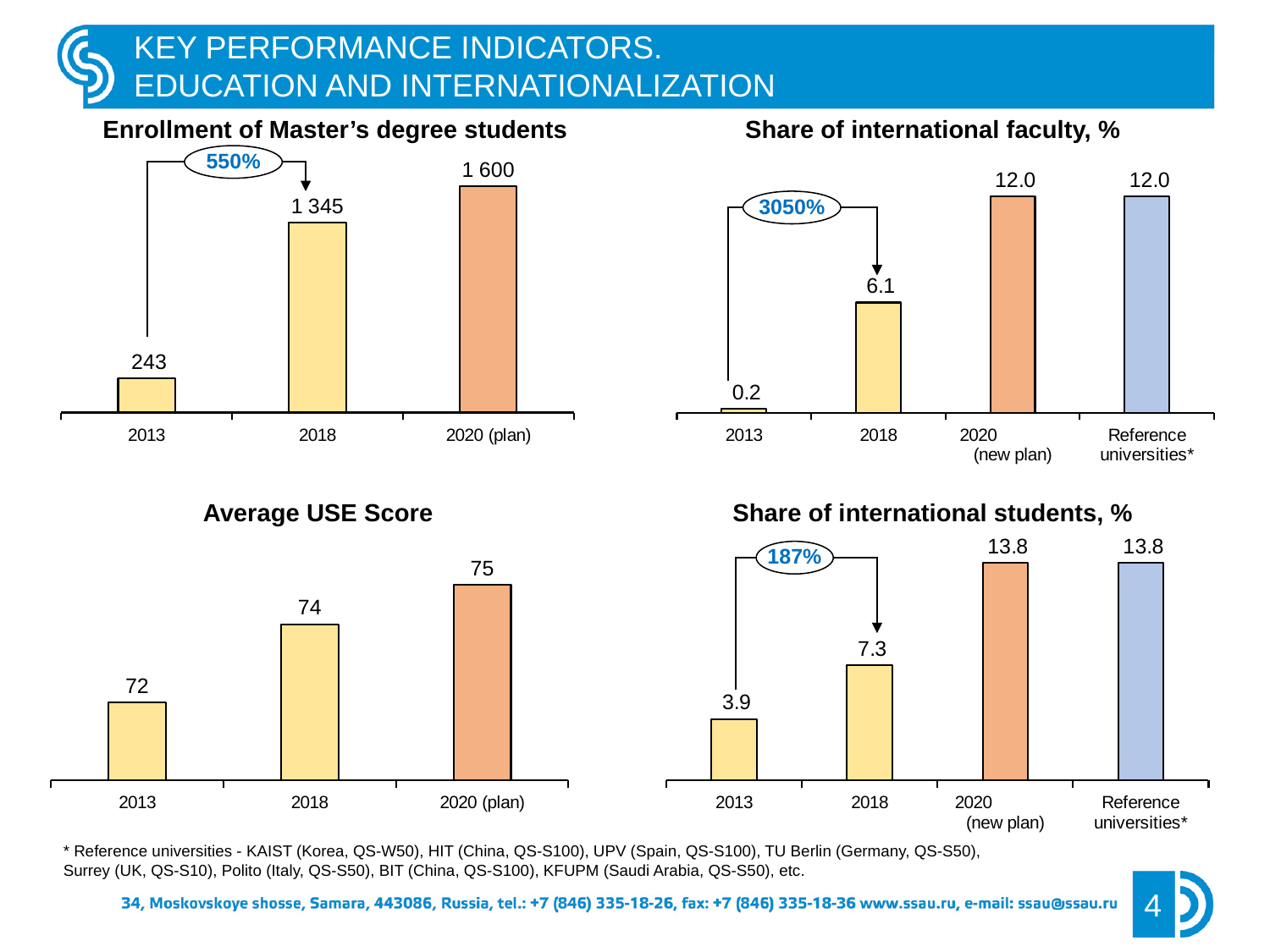
In the 'Enrollment of Master's degree students' chart, what is the value for 2018? 1 345 In the 'Share of international faculty, %' chart, how many bars are plotted? 4 In the 'Average USE Score' chart, do the values rise or fall from 2013 to 2020 (plan)? rise In the 'Enrollment of Master's degree students' chart, what is the planned value for 2020? 1 600 What type of chart is the 'Average USE Score' chart? bar chart In the 'Share of international faculty, %' chart, what is the difference between the 2020 (new plan) value and the 2018 value? 5.9 In the 'Share of international students, %' chart, what is the value for 2013? 3.9 In the 'Enrollment of Master's degree students' chart, which year has the lowest value? 2013 In the 'Share of international students, %' chart, which is larger: the 2020 (new plan) value or the 2018 value? 2020 (new plan) In the 'Average USE Score' chart, what is the value for 2013? 72 In the 'Share of international faculty, %' chart, what is the value for 2018? 6.1 In the 'Share of international students, %' chart, what is the difference between the 2018 value and the 2013 value? 3.4